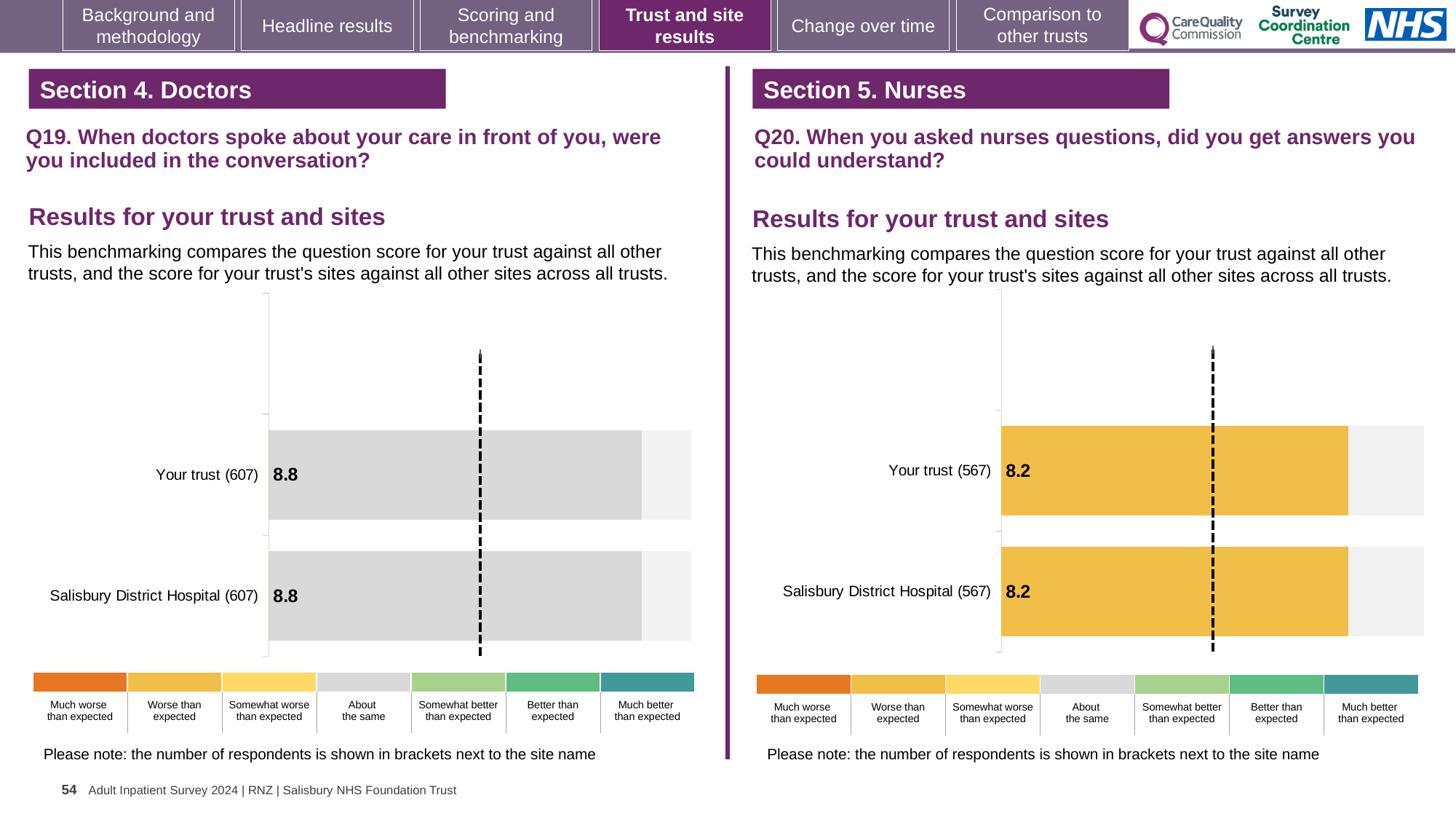
What kind of chart is used on the Q19 chart (Section 4. Doctors)? bar chart How many respondents are shown in brackets for Your trust on the Q19 chart (Section 4. Doctors)? 607 On the Q19 chart (Section 4. Doctors), what is the difference between the score for Your trust and the score for Salisbury District Hospital? 0 According to the colour key, which category do the bars on the Q19 chart (Section 4. Doctors) fall into? About the same On the Q20 chart (Section 5. Nurses), what is the score for Salisbury District Hospital? 8.2 How many respondents are shown in brackets for Salisbury District Hospital on the Q20 chart (Section 5. Nurses)? 567 How many bars are plotted on the Q20 chart (Section 5. Nurses)? 2 On the Q19 chart (Section 4. Doctors), what is the score for Your trust? 8.8 On the Q19 chart (Section 4. Doctors), what is the score for Salisbury District Hospital? 8.8 How many categories does the colour key below the Q20 chart (Section 5. Nurses) list? 7 On the Q20 chart (Section 5. Nurses), what is the score for Your trust? 8.2 Is the score for Your trust on the Q19 chart (Section 4. Doctors) larger or smaller than the score for Your trust on the Q20 chart (Section 5. Nurses)? larger